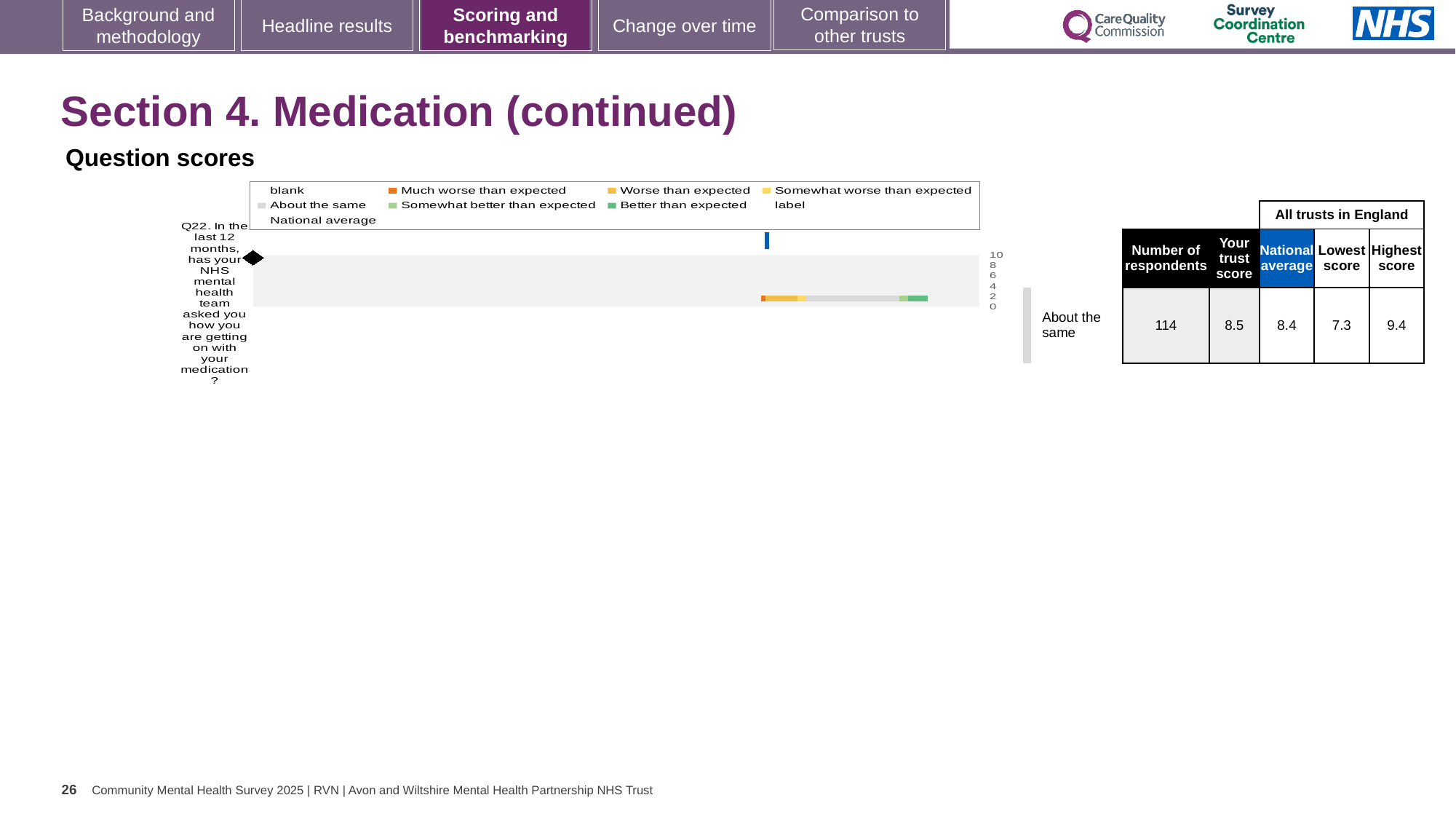
How many questions (categories) are plotted in the 'Question scores' chart? 1 What is the national average for Q22 shown in the table beside the chart? 8.4 What is the highest score among all trusts in England for Q22? 9.4 What is the trust score for Q22 shown in the table beside the chart? 8.5 How many respondents answered Q22 according to the table beside the chart? 114 Which is larger for Q22, the trust score or the national average? the trust score Which question number is plotted in the 'Question scores' chart? Q22 What kind of chart is shown under 'Question scores'? bar chart How many entries does the legend of the 'Question scores' chart list? 9 What benchmark category is shown for Q22 next to the chart? About the same What is the lowest score among all trusts in England for Q22? 7.3 What is the highest tick value shown on the axis of the 'Question scores' chart? 10